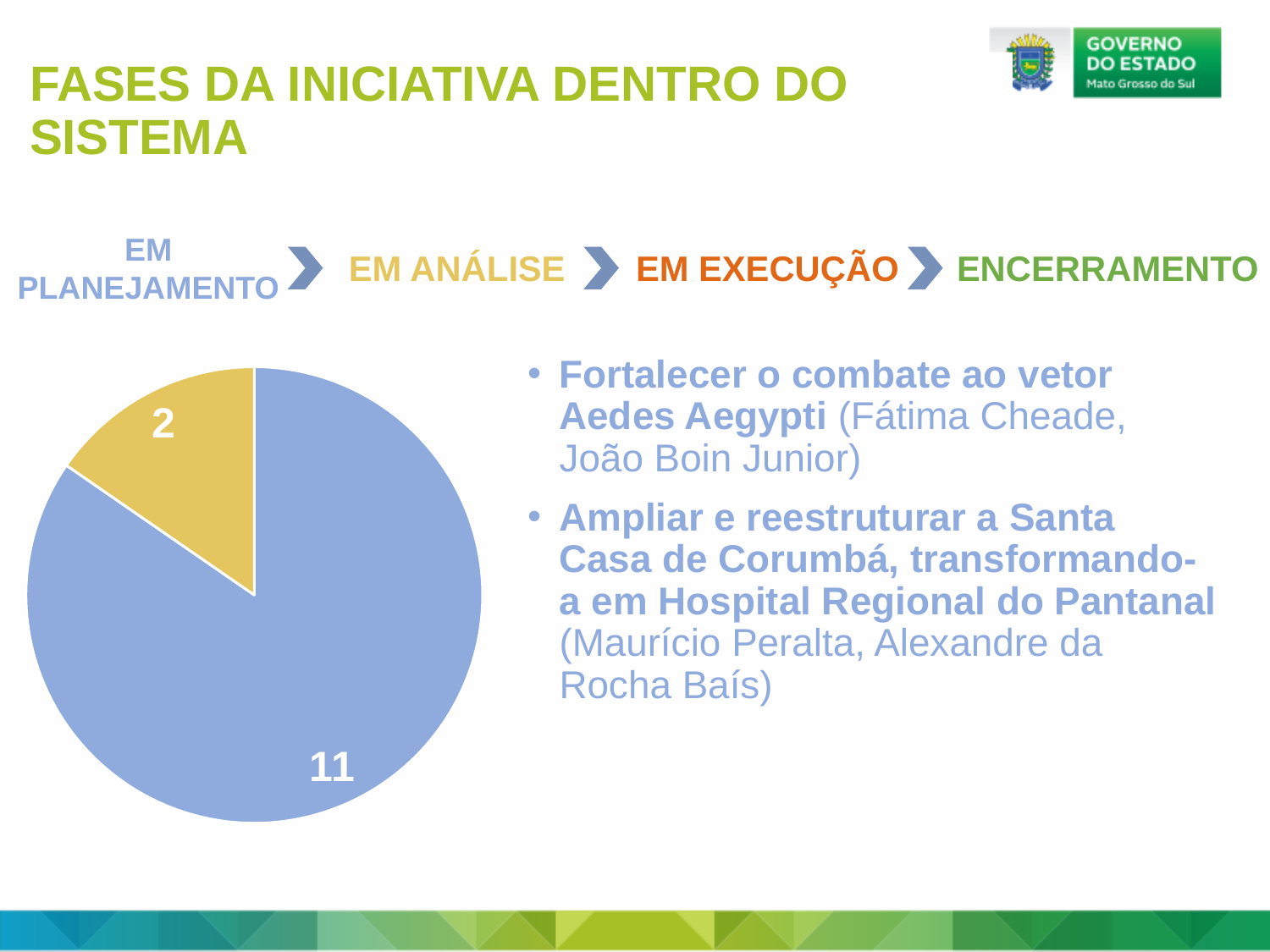
What value is shown on the blue slice of the pie chart? 11 How many slices does the pie chart have? 2 Which slice of the pie chart has the largest value? the blue slice (11) Does the pie chart have a legend? No What is the difference between the values of the blue and yellow slices? 9 Which slice of the pie chart has the smallest value? the yellow slice (2) Is the blue slice or the yellow slice larger? the blue slice What is the total of the values shown in the pie chart? 13 What value is shown on the yellow slice of the pie chart? 2 What colour is the slice labelled 2? yellow What type of chart is shown on the slide? pie chart